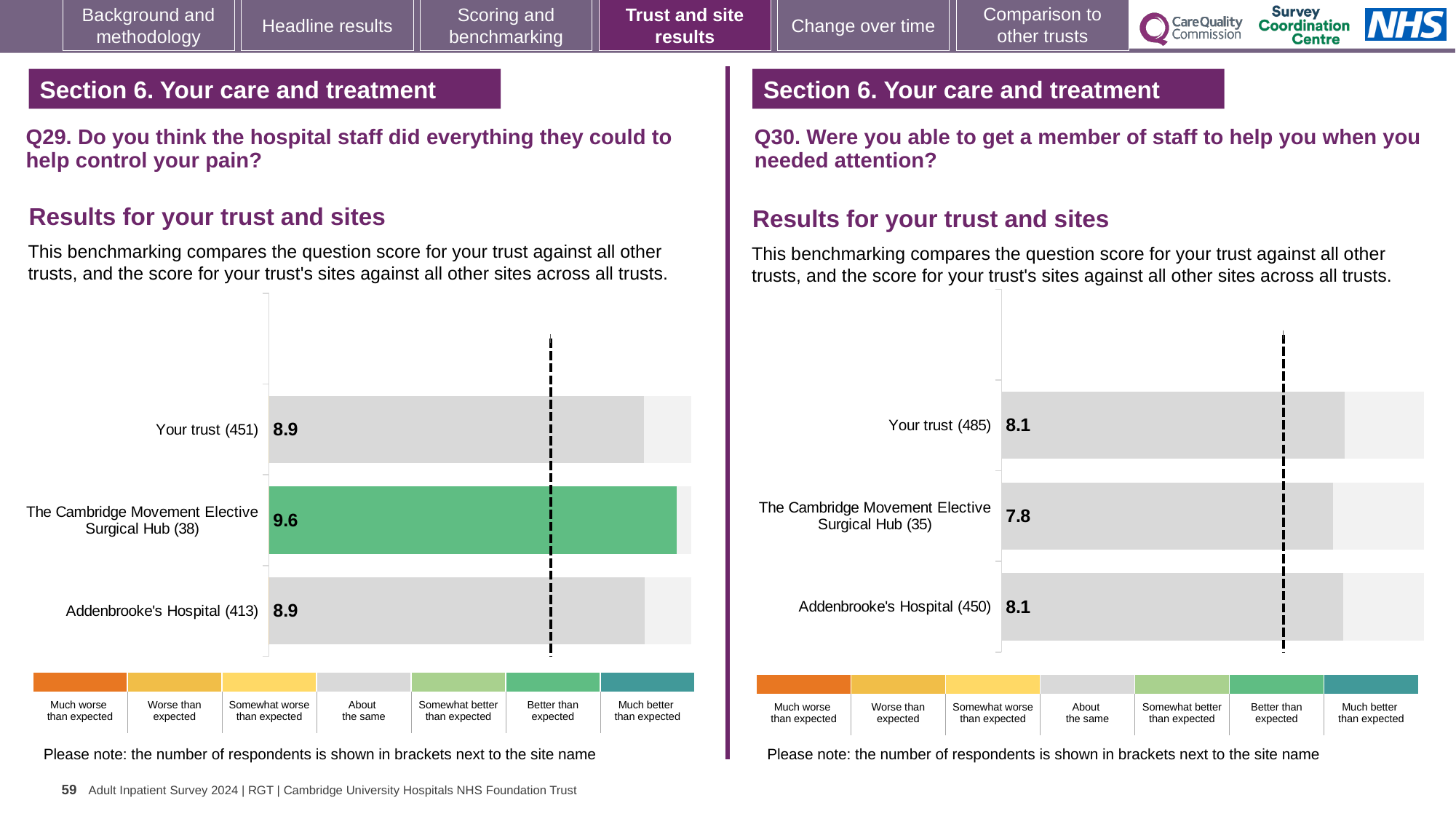
In the Q29 chart on the left, what is the score for Your trust (451)? 8.9 In the Q29 chart on the left, what is the difference between the score for The Cambridge Movement Elective Surgical Hub (38) and the score for Addenbrooke's Hospital (413)? 0.7 In the Q30 chart on the right, which is larger: the score for Your trust (485) or the score for The Cambridge Movement Elective Surgical Hub (35)? Your trust (485) In the Q30 chart on the right, what is the score for Addenbrooke's Hospital (450)? 8.1 How many bars are plotted in the Q29 chart on the left? 3 What kind of chart is used in the Q30 chart on the right? Bar chart In the Q29 chart on the left, which site or trust has the highest score? The Cambridge Movement Elective Surgical Hub (38) In the Q29 chart on the left, what is the score for The Cambridge Movement Elective Surgical Hub (38)? 9.6 In the Q30 chart on the right, which site or trust has the lowest score? The Cambridge Movement Elective Surgical Hub (35) In the Q30 chart on the right, what is the difference between the score for Your trust (485) and the score for The Cambridge Movement Elective Surgical Hub (35)? 0.3 In the Q29 chart on the left, which bar is coloured green rather than grey? The Cambridge Movement Elective Surgical Hub (38) In the Q30 chart on the right, what is the score for The Cambridge Movement Elective Surgical Hub (35)? 7.8